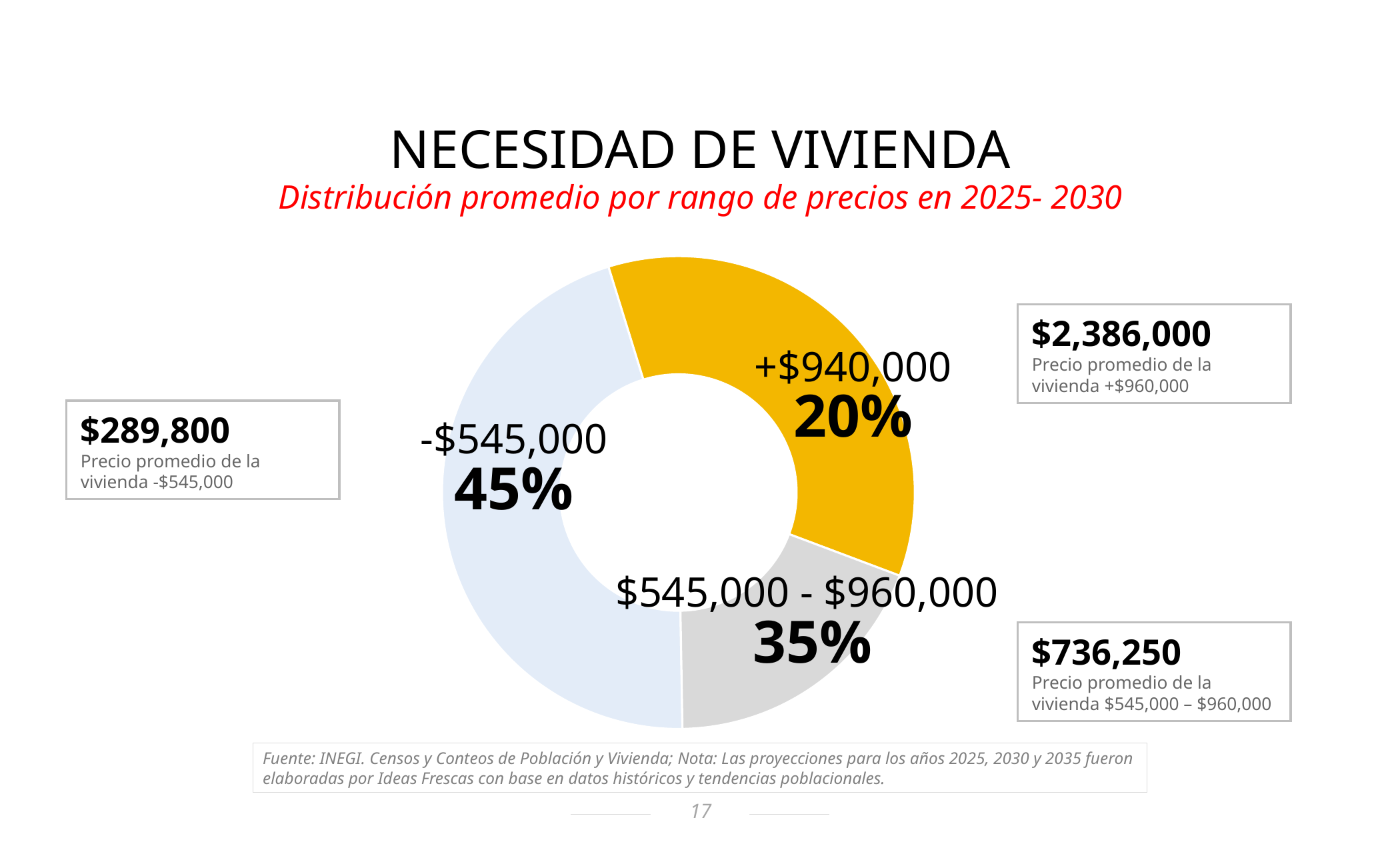
Which price range has the smallest share of the chart? +$940,000 What share of the chart does the $545,000 - $960,000 price range represent? 35% What share of the chart does the -$545,000 price range represent? 45% What is the combined share of the $545,000 - $960,000 and +$940,000 segments? 55% What is the difference in percentage points between the -$545,000 segment and the +$940,000 segment? 25 percentage points What colour is the +$940,000 segment of the chart? Yellow/gold What share of the chart does the +$940,000 price range represent? 20% Which segment is larger: $545,000 - $960,000 or +$940,000? $545,000 - $960,000 How many segments does the donut chart have? 3 What is the red subtitle of the chart on the slide? Distribución promedio por rango de precios en 2025- 2030 Which price range has the largest share of the chart? -$545,000 What kind of chart is shown on the slide? Donut (pie) chart